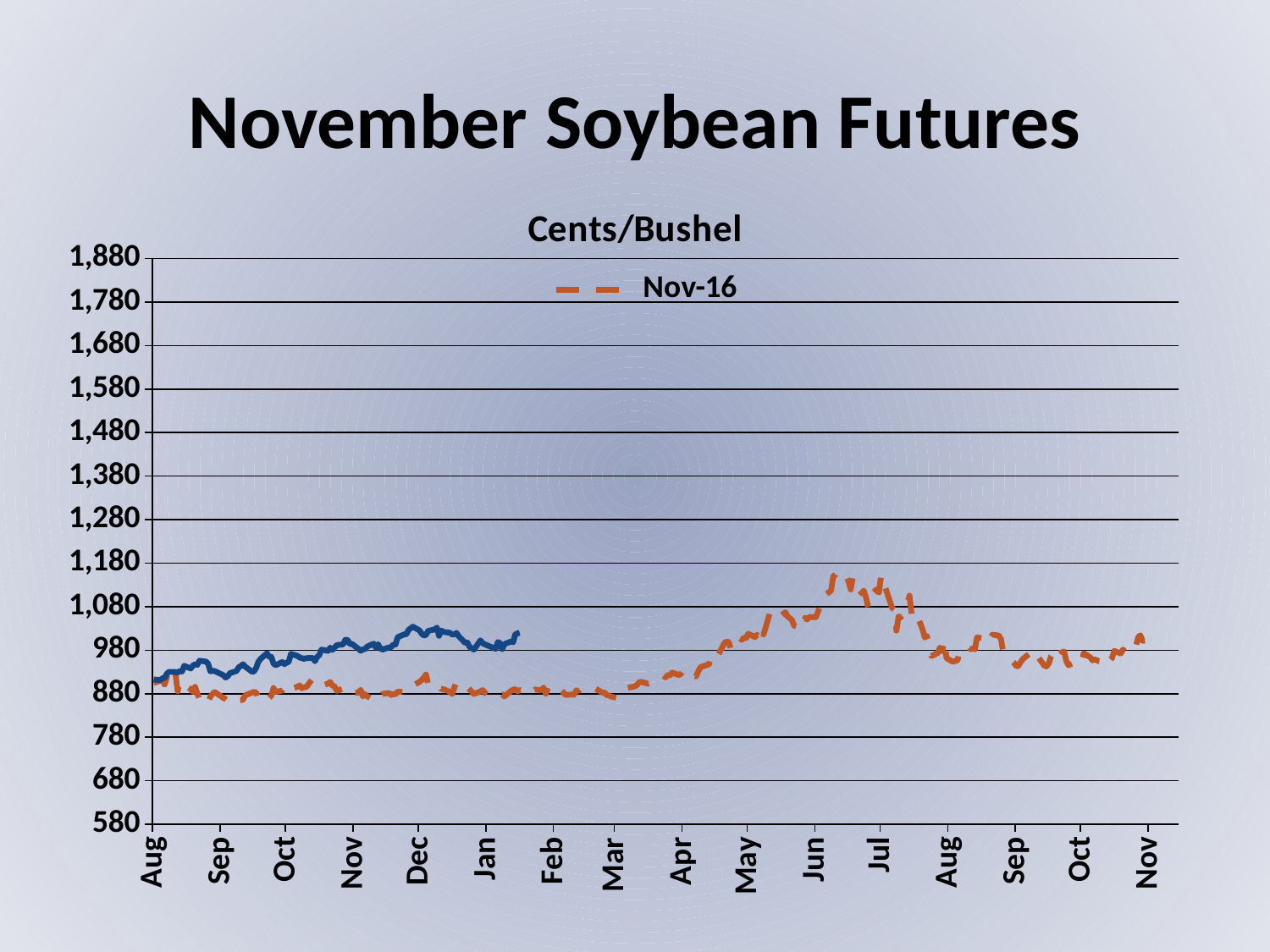
Which is larger for the Nov-16 series: the value at Jun or the value at Mar? Jun Is the value of the solid blue line at Dec greater or less than 980? greater How many series does the chart's legend list? 1 What kind of chart is shown on the slide? line chart Is the value of the Nov-16 series at Sep (first Sep label) greater or less than 980? less What is the name of the series shown in the legend? Nov-16 Is the peak value of the Nov-16 series greater or less than 1,080? greater Does the Nov-16 series rise or fall between Jul and Aug (second Aug label)? fall How many month labels are shown along the x axis? 16 What is the title printed above the chart's plot area? Cents/Bushel Does the Nov-16 series rise or fall between Mar and Jun? rise